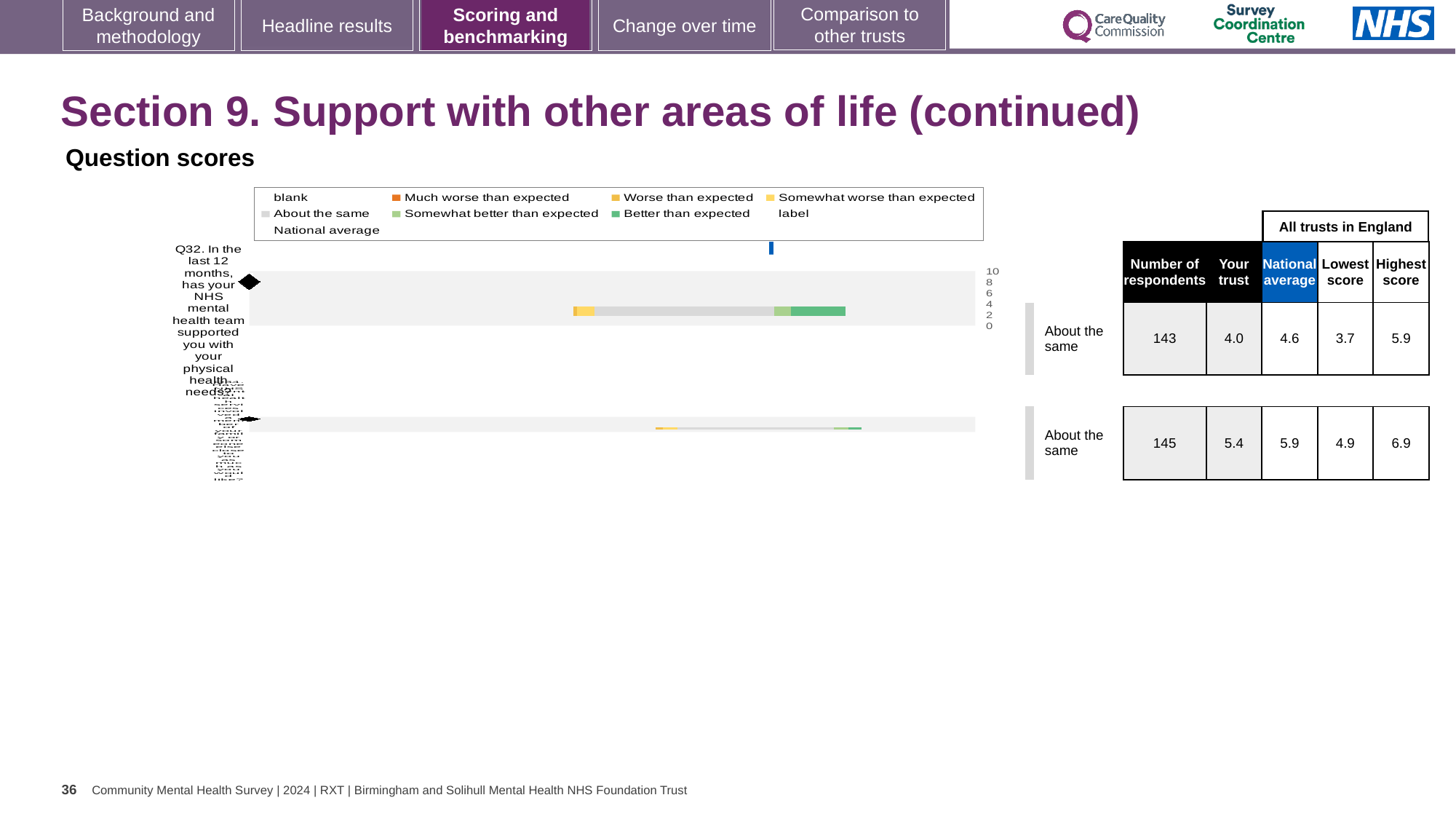
How many question bars are plotted in the chart? 2 What is the national average score for Q32? 4.6 How is the trust's Q32 result categorised relative to expectations? About the same For Q32, what is the difference between the highest and lowest scores across all trusts in England? 2.2 What kind of chart is shown on the slide? bar chart For Q32, how much higher is the national average than the trust's score? 0.6 What is the lowest score among all trusts in England for Q32? 3.7 What is the 'Your trust' score for Q32? 4.0 For Q32, which is larger: the trust's score or the national average? national average What is the highest score among all trusts in England for Q32? 5.9 Which colour in the legend represents 'Better than expected'? green How many respondents answered Q32? 143